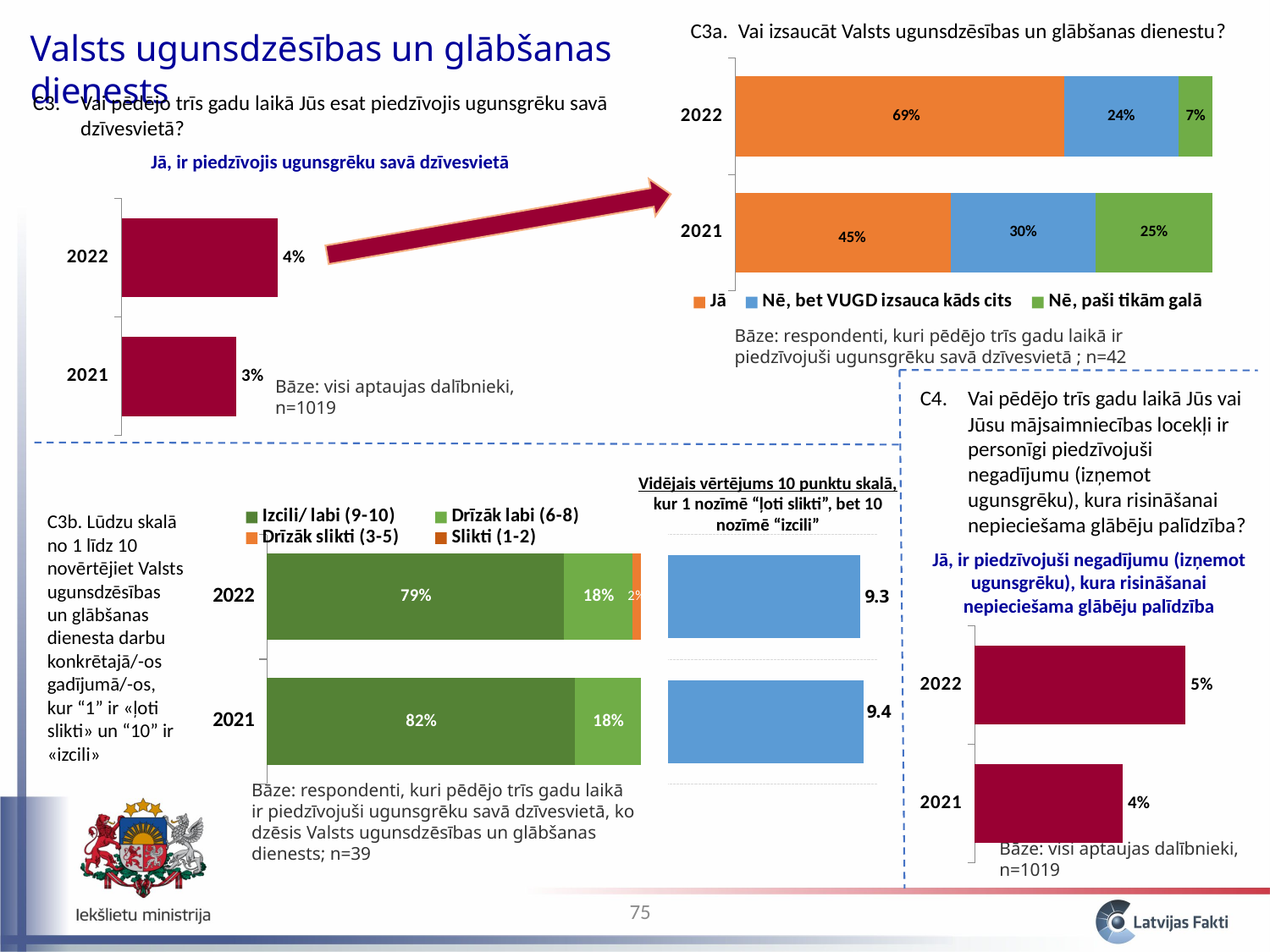
In the chart 'Vidējais vērtējums 10 punktu skalā', what is the average rating for 2021? 9.4 What kind of chart is the C4 chart 'Jā, ir piedzīvojuši negadījumu (izņemot ugunsgrēku)...'? Bar chart In the C4 chart 'Jā, ir piedzīvojuši negadījumu (izņemot ugunsgrēku)...', what is the value for 2022? 5% In the C3a chart 'Vai izsaucāt Valsts ugunsdzēsības un glābšanas dienestu?', what is the difference between the 'Jā' share in 2022 and in 2021? 24 percentage points In the chart 'Vidējais vērtējums 10 punktu skalā', what is the average rating for 2022? 9.3 In the C3b chart, which year has the larger 'Izcili/ labi (9-10)' share, 2022 or 2021? 2021 In the C3b chart, what is the 'Izcili/ labi (9-10)' share for 2021? 82% In the C3a chart 'Vai izsaucāt Valsts ugunsdzēsības un glābšanas dienestu?', how many series does the legend list? 3 In the C3a chart 'Vai izsaucāt Valsts ugunsdzēsības un glābšanas dienestu?', what is the 'Nē, paši tikām galā' share for 2021? 25% In the C3 chart 'Jā, ir piedzīvojis ugunsgrēku savā dzīvesvietā', what is the value for 2021? 3% In the C3a chart 'Vai izsaucāt Valsts ugunsdzēsības un glābšanas dienestu?', what is the 'Jā' share for 2022? 69% In the C3 chart 'Jā, ir piedzīvojis ugunsgrēku savā dzīvesvietā', what is the value for 2022? 4%